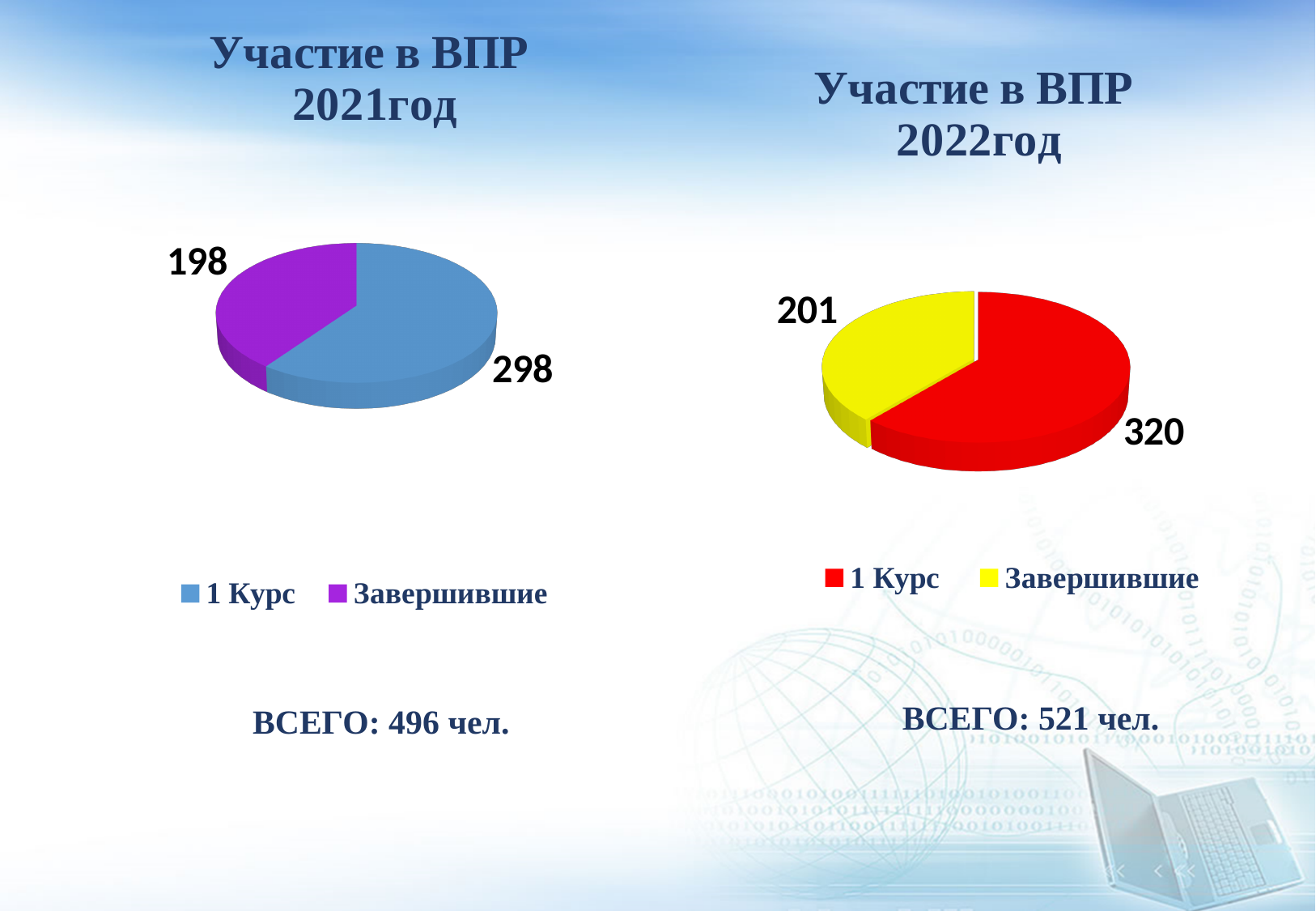
In the chart titled 'Участие в ВПР 2022год', what colour is the '1 Курс' slice? Red In the chart titled 'Участие в ВПР 2021год', which category has the largest slice? 1 Курс In the chart titled 'Участие в ВПР 2022год', which category has the smallest slice? Завершившие In the chart titled 'Участие в ВПР 2022год', what is the value for 'Завершившие'? 201 Is the value for '1 Курс' larger in the 2021 chart or in the 2022 chart? 2022 chart In the chart titled 'Участие в ВПР 2022год', what is the value for '1 Курс'? 320 In the chart titled 'Участие в ВПР 2021год', what is the difference between '1 Курс' and 'Завершившие'? 100 In the chart titled 'Участие в ВПР 2021год', what is the value for '1 Курс'? 298 What type of chart is used on the left side of the slide ('Участие в ВПР 2021год')? Pie chart In the chart titled 'Участие в ВПР 2022год', what is the difference between '1 Курс' and 'Завершившие'? 119 How many series does the legend of the chart titled 'Участие в ВПР 2022год' list? 2 In the chart titled 'Участие в ВПР 2021год', what is the value for 'Завершившие'? 198